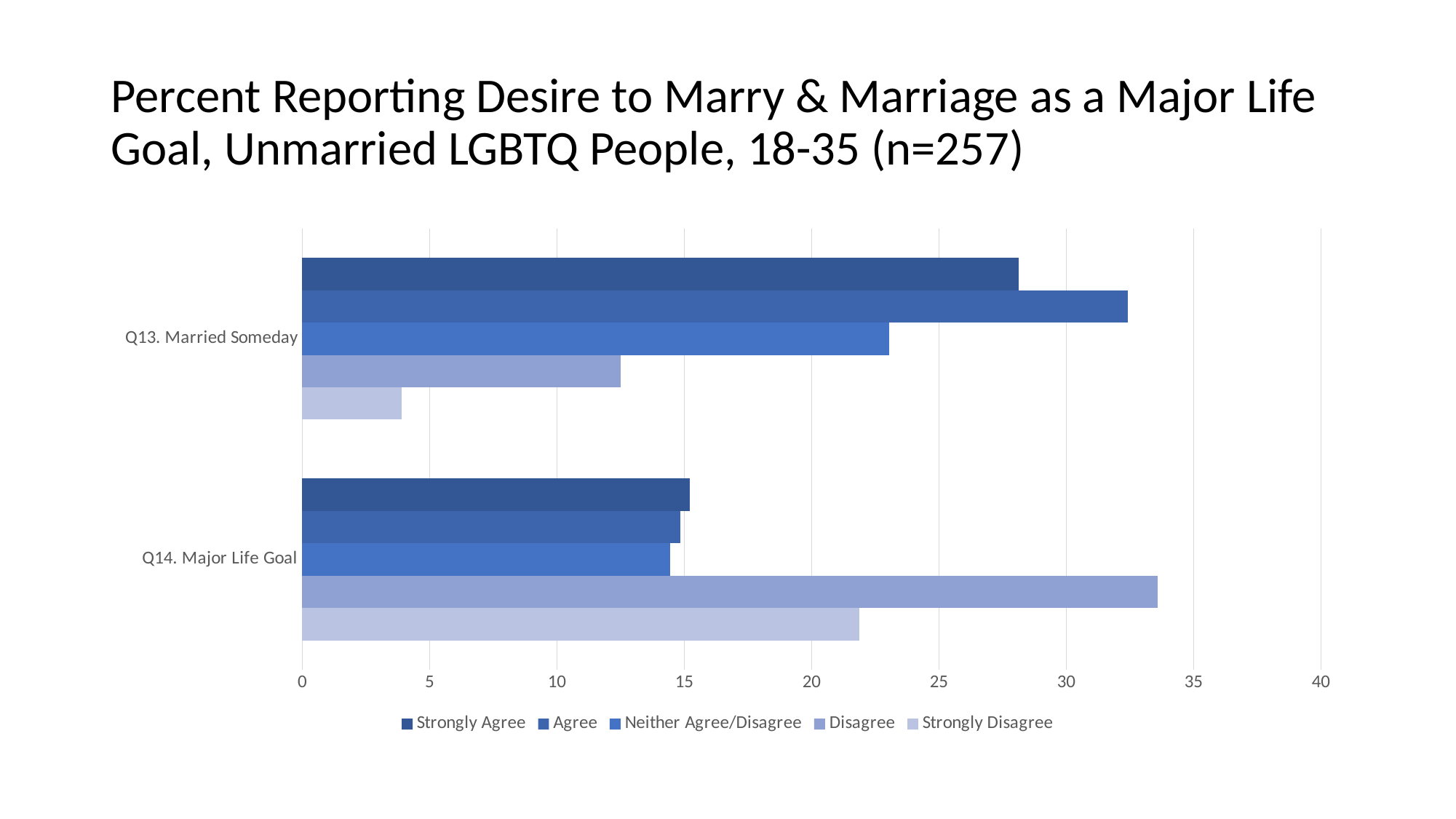
Is the value for Neither Agree/Disagree under Q13. Married Someday greater or less than 20? greater For Q13. Married Someday, which response has the longest bar? Agree For Q14. Major Life Goal, which response has the longest bar? Disagree Which is larger: Disagree for Q13. Married Someday or Disagree for Q14. Major Life Goal? Q14. Major Life Goal Is the value for Strongly Disagree under Q13. Married Someday greater or less than 5? less Is the value for Agree under Q13. Married Someday greater or less than 30? greater How many series does the legend list? 5 For Q13. Married Someday, which response has the shortest bar? Strongly Disagree Which is larger: Strongly Agree for Q13. Married Someday or Strongly Agree for Q14. Major Life Goal? Q13. Married Someday What kind of chart is shown on the slide? bar chart How many question categories are shown on the y axis? 2